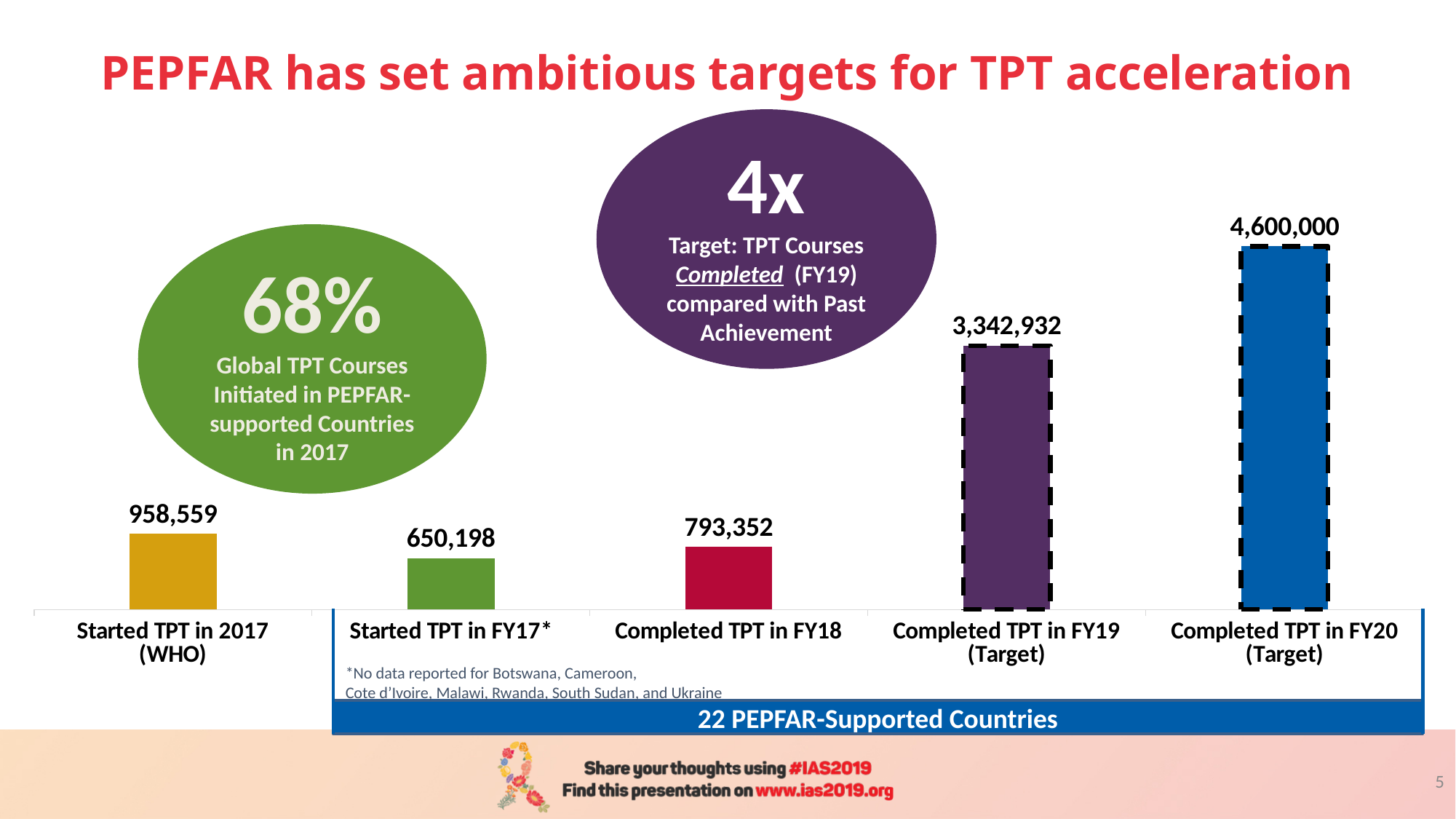
What type of chart is shown on the slide? Bar chart What is the difference between Started TPT in 2017 (WHO) and Started TPT in FY17*? 308,361 What is the difference between the FY20 target and the FY19 target for Completed TPT? 1,257,068 What is the target value for Completed TPT in FY20? 4,600,000 How many bars are shown in the chart? 5 What is the value for Started TPT in 2017 (WHO)? 958,559 What is the value for Started TPT in FY17*? 650,198 What is the value for Completed TPT in FY18? 793,352 Which is larger: Completed TPT in FY18 or Started TPT in FY17*? Completed TPT in FY18 Which category has the lowest value? Started TPT in FY17* Which category has the highest value? Completed TPT in FY20 (Target) What is the target value for Completed TPT in FY19? 3,342,932